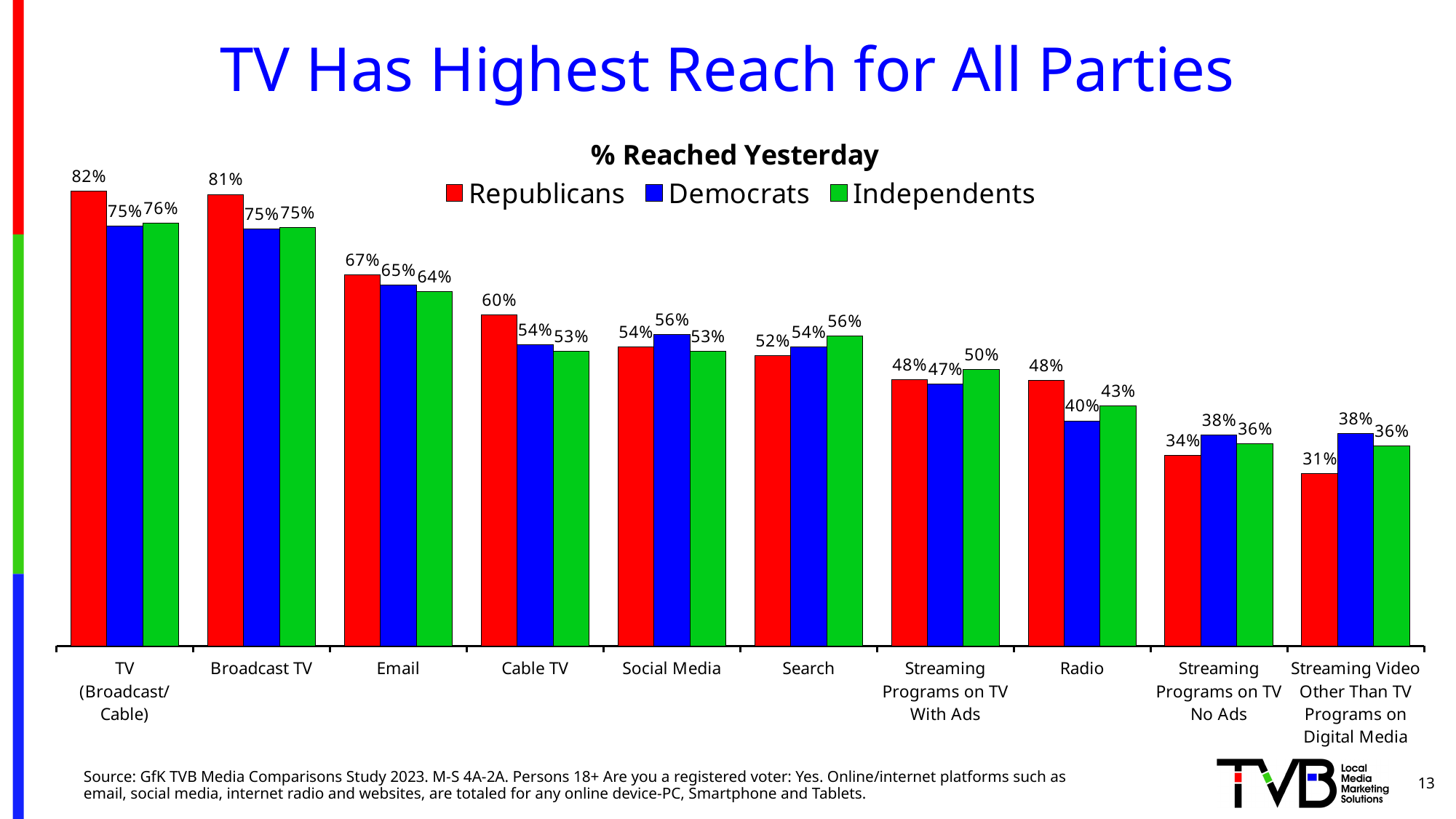
What is the Democrats value for Radio? 40% Do the Republicans values generally rise or fall from left to right across the categories? Fall What is the Independents value for Streaming Programs on TV With Ads? 50% What is the difference between the Republicans and Democrats values for Cable TV? 6% For Radio, which is larger: the Republicans value or the Independents value? Republicans What is the Republicans value for TV (Broadcast/Cable)? 82% Which category has the highest Republicans value? TV (Broadcast/Cable) How many series does the legend list? 3 What is the title of the chart? % Reached Yesterday How many categories are shown on the x axis? 10 Which category has the lowest Republicans value? Streaming Video Other Than TV Programs on Digital Media What kind of chart is shown on the slide? Bar chart